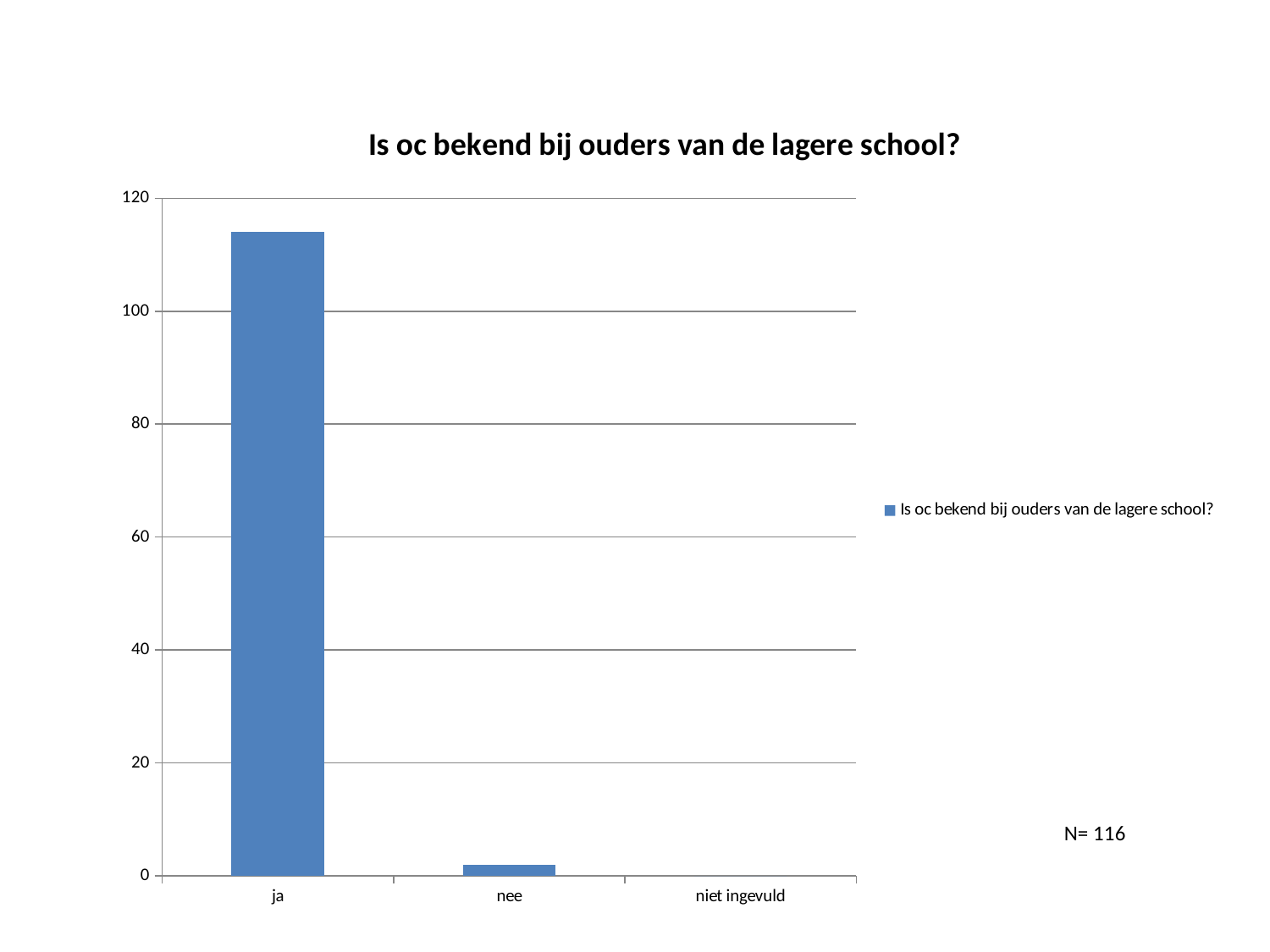
Is the value for nee greater or less than 20? less How many categories are shown on the x axis? 3 How many series does the legend list? 1 Which category has the lowest value? niet ingevuld What kind of chart is shown on the slide? bar chart Do the values rise or fall from left to right along the x axis? fall Which category has the highest value? ja What is the N value stated on the slide? N= 116 Is the value for ja greater or less than 100? greater What is the title of the chart? Is oc bekend bij ouders van de lagere school? Which is larger, the value for ja or the value for nee? ja